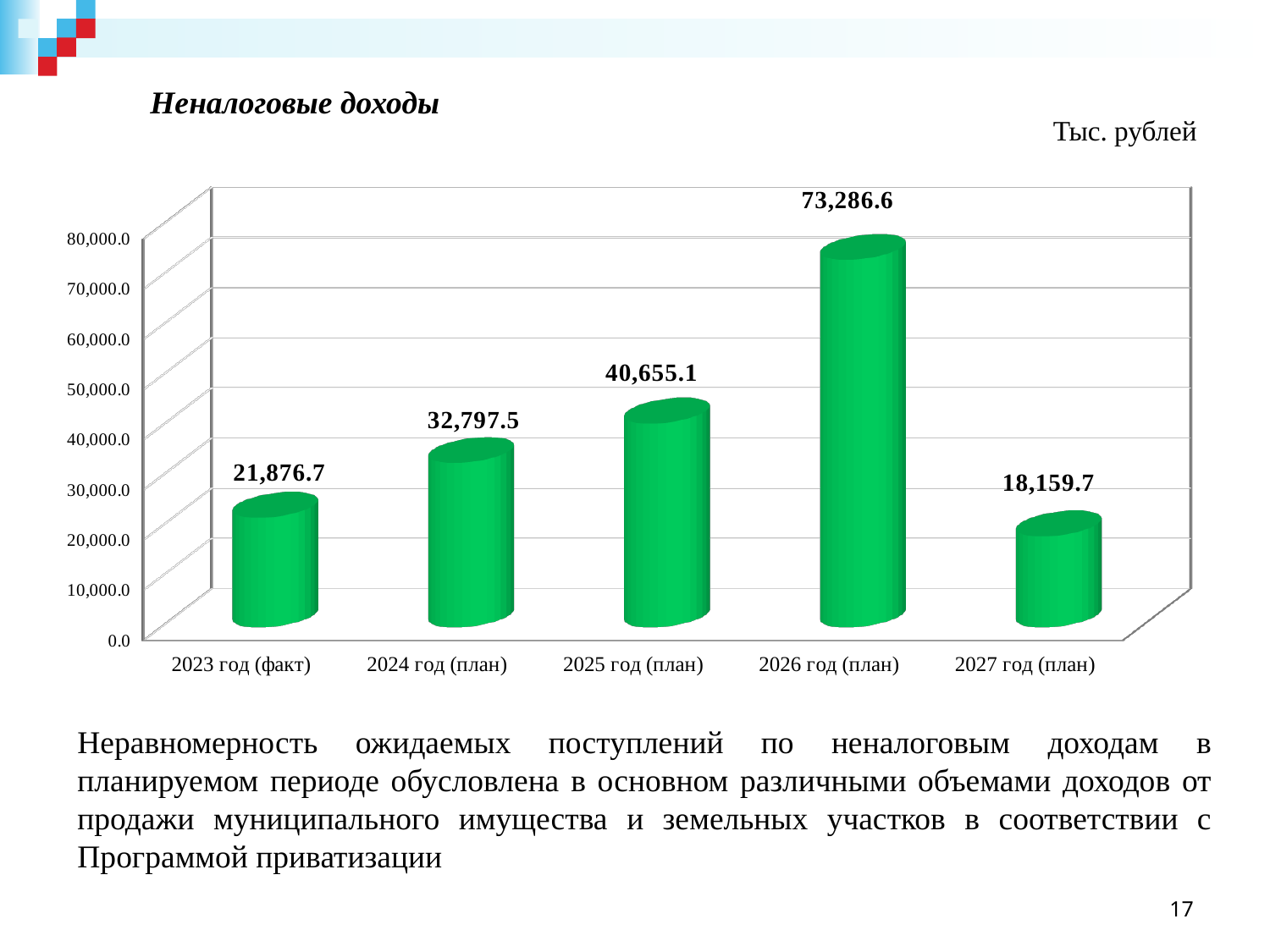
Which is larger, the value for 2025 год (план) or the value for 2024 год (план)? 2025 год (план) What is the title of the chart? Неналоговые доходы What kind of chart is this? Bar chart How many categories are shown on the x axis? 5 What is the difference between the values for 2024 год (план) and 2023 год (факт)? 10,920.8 What is the value for 2027 год (план)? 18,159.7 Do the values rise or fall from 2023 год (факт) to 2026 год (план)? Rise What is the value for 2023 год (факт)? 21,876.7 Which category has the lowest value? 2027 год (план) What is the value for 2026 год (план)? 73,286.6 Which category has the highest value? 2026 год (план) What is the difference between the values for 2026 год (план) and 2027 год (план)? 55,126.9